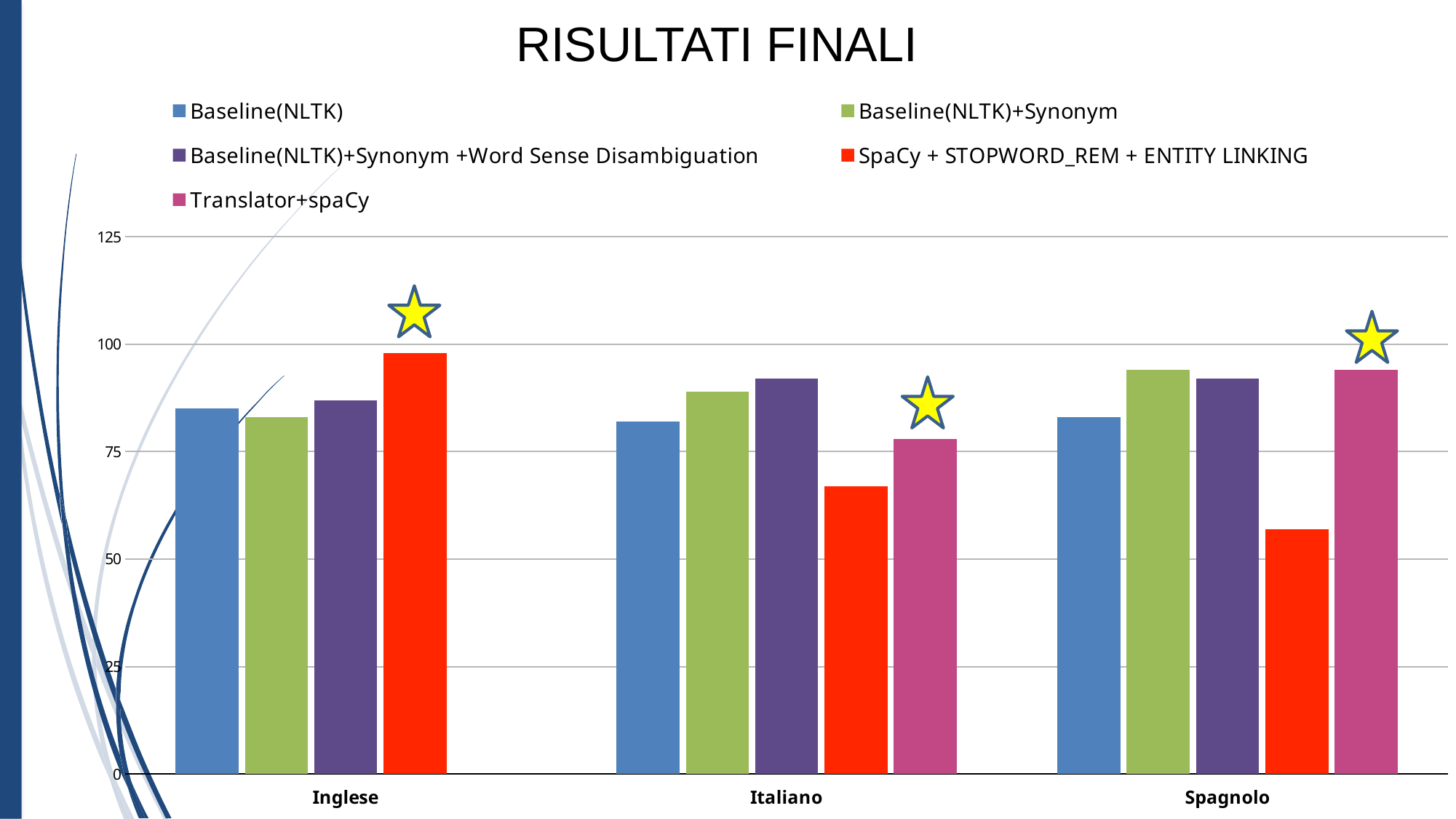
Which series has the highest value for Inglese? SpaCy + STOPWORD_REM + ENTITY LINKING Which series has the lowest value for Italiano? SpaCy + STOPWORD_REM + ENTITY LINKING For Italiano, which is larger: Translator+spaCy or SpaCy + STOPWORD_REM + ENTITY LINKING? Translator+spaCy Is the value for SpaCy + STOPWORD_REM + ENTITY LINKING in Spagnolo greater or less than 75? less Which series has the lowest value for Spagnolo? SpaCy + STOPWORD_REM + ENTITY LINKING Is the value for SpaCy + STOPWORD_REM + ENTITY LINKING in Inglese greater or less than 75? greater How many language categories are shown on the x axis? 3 Do the values for SpaCy + STOPWORD_REM + ENTITY LINKING rise or fall from Inglese to Spagnolo? fall What kind of chart is shown on the slide? bar chart What is the title of the slide? RISULTATI FINALI For Spagnolo, which is larger: Baseline(NLTK) or SpaCy + STOPWORD_REM + ENTITY LINKING? Baseline(NLTK) How many series does the legend list? 5